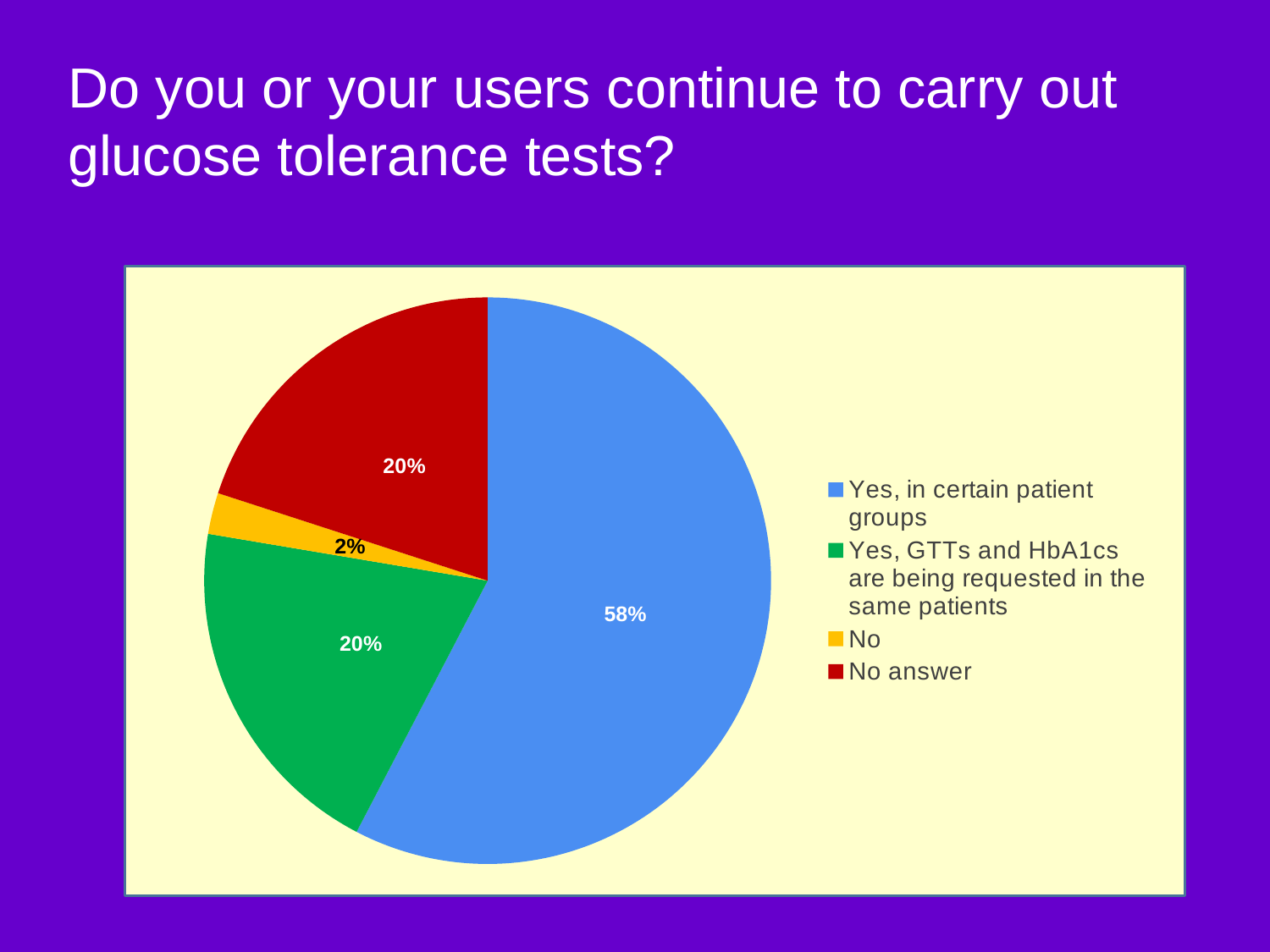
What percentage of respondents answered "No"? 2% Which response has the largest share of the pie? Yes, in certain patient groups What percentage of respondents answered "Yes, GTTs and HbA1cs are being requested in the same patients"? 20% What percentage of respondents answered "Yes, in certain patient groups"? 58% Which response has the smallest share of the pie? No What colour is the slice for "No"? Yellow Which is larger: the share for "No" or the share for "No answer"? No answer What kind of chart is shown on the slide? Pie chart How many slices does the pie chart have? 4 How many entries does the legend list? 4 What percentage of respondents gave "No answer"? 20% What is the difference in percentage points between "Yes, in certain patient groups" and "No answer"? 38